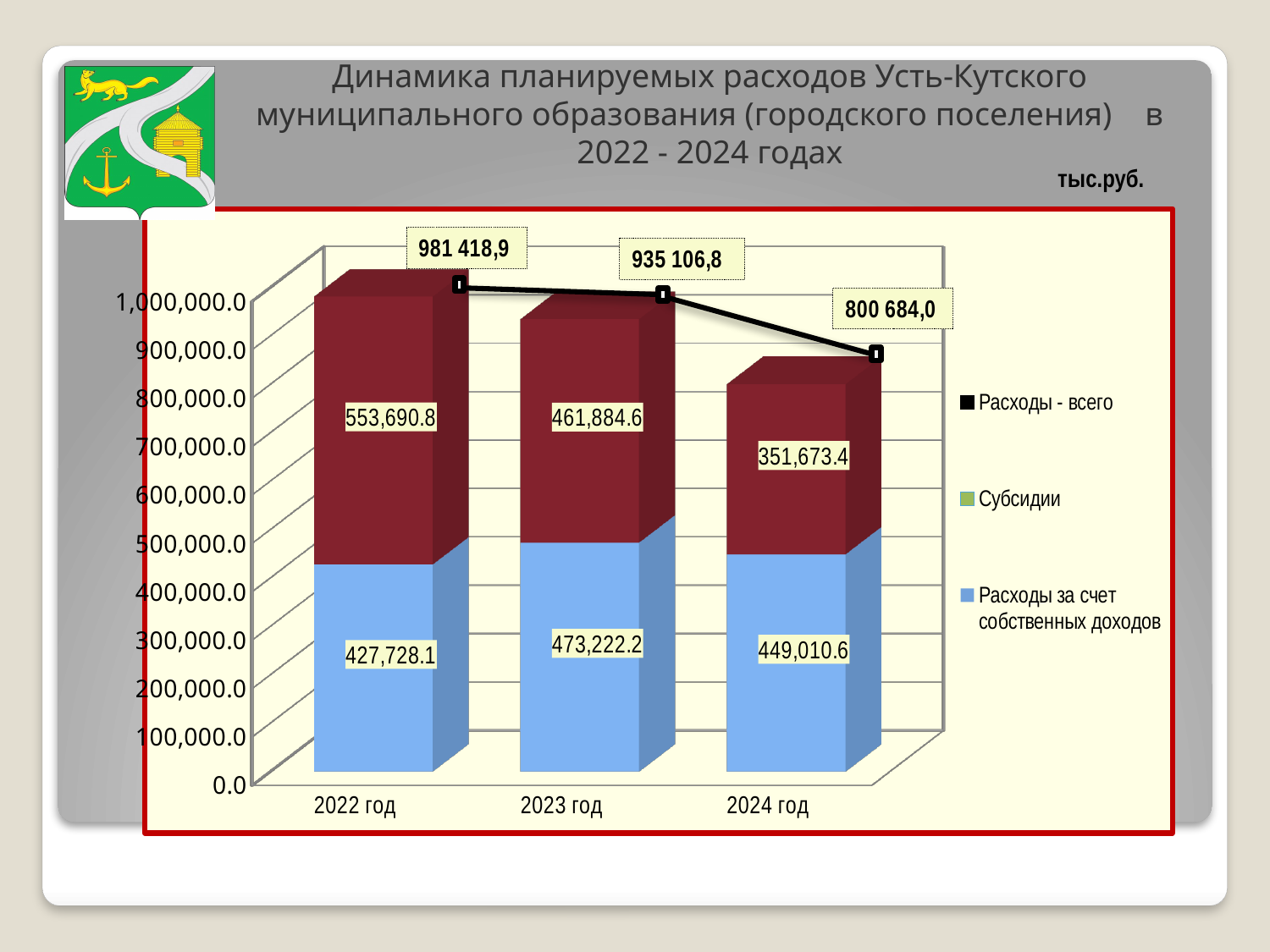
What is the value of the upper (dark red) segment of the bar for 2024 год? 351,673.4 What unit of measurement is indicated for the chart? тыс.руб. What kind of chart is shown on the slide? Bar chart (stacked, with a line) In which year is Расходы за счет собственных доходов the lowest? 2022 год What is the value of Расходы - всего for 2023 год? 935 106,8 How many series does the legend list? 3 How many years are shown on the x axis of the chart? 3 In which year is Расходы - всего the highest? 2022 год Does Расходы - всего rise or fall from 2022 год to 2024 год? Fall What is the value of Расходы за счет собственных доходов for 2022 год? 427,728.1 Which year has the larger value of Расходы за счет собственных доходов, 2023 год or 2024 год? 2023 год What is the difference between Расходы - всего in 2022 год and in 2024 год? 180 734,9